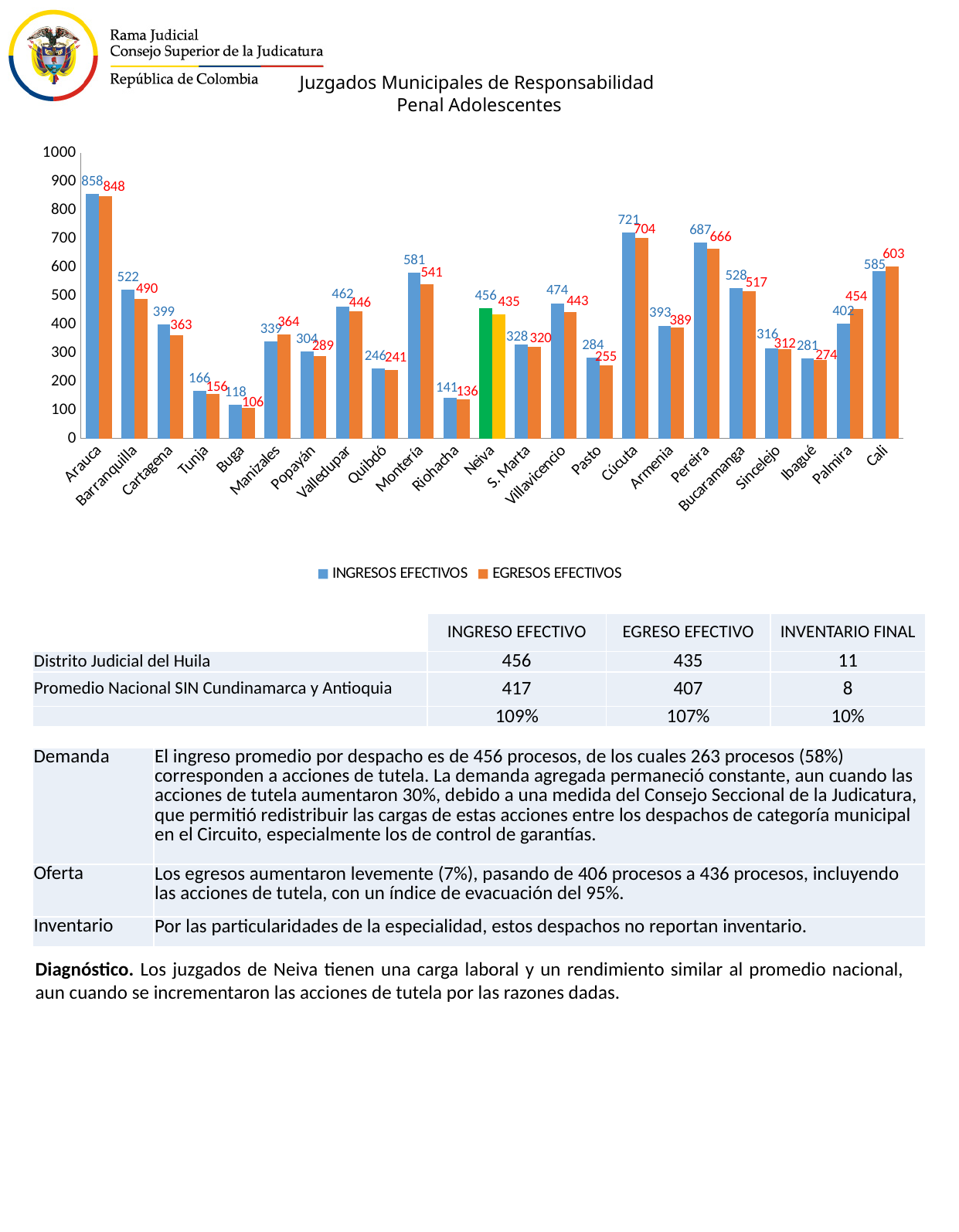
What is the EGRESOS EFECTIVOS value for Cali? 603 Which city has the highest INGRESOS EFECTIVOS value? Arauca Which is larger for Palmira, INGRESOS EFECTIVOS or EGRESOS EFECTIVOS? EGRESOS EFECTIVOS What is the INGRESOS EFECTIVOS value for Neiva? 456 What is the difference between INGRESOS EFECTIVOS and EGRESOS EFECTIVOS for Cúcuta? 17 Which city has the lowest EGRESOS EFECTIVOS value? Buga Which city has a higher INGRESOS EFECTIVOS value, Pereira or Bucaramanga? Pereira What type of chart is shown on the slide? bar chart Which city's bars are highlighted in green and yellow instead of the legend colours? Neiva How many series does the legend list? 2 How many cities are shown on the x axis of the chart? 23 What is the EGRESOS EFECTIVOS value for Montería? 541